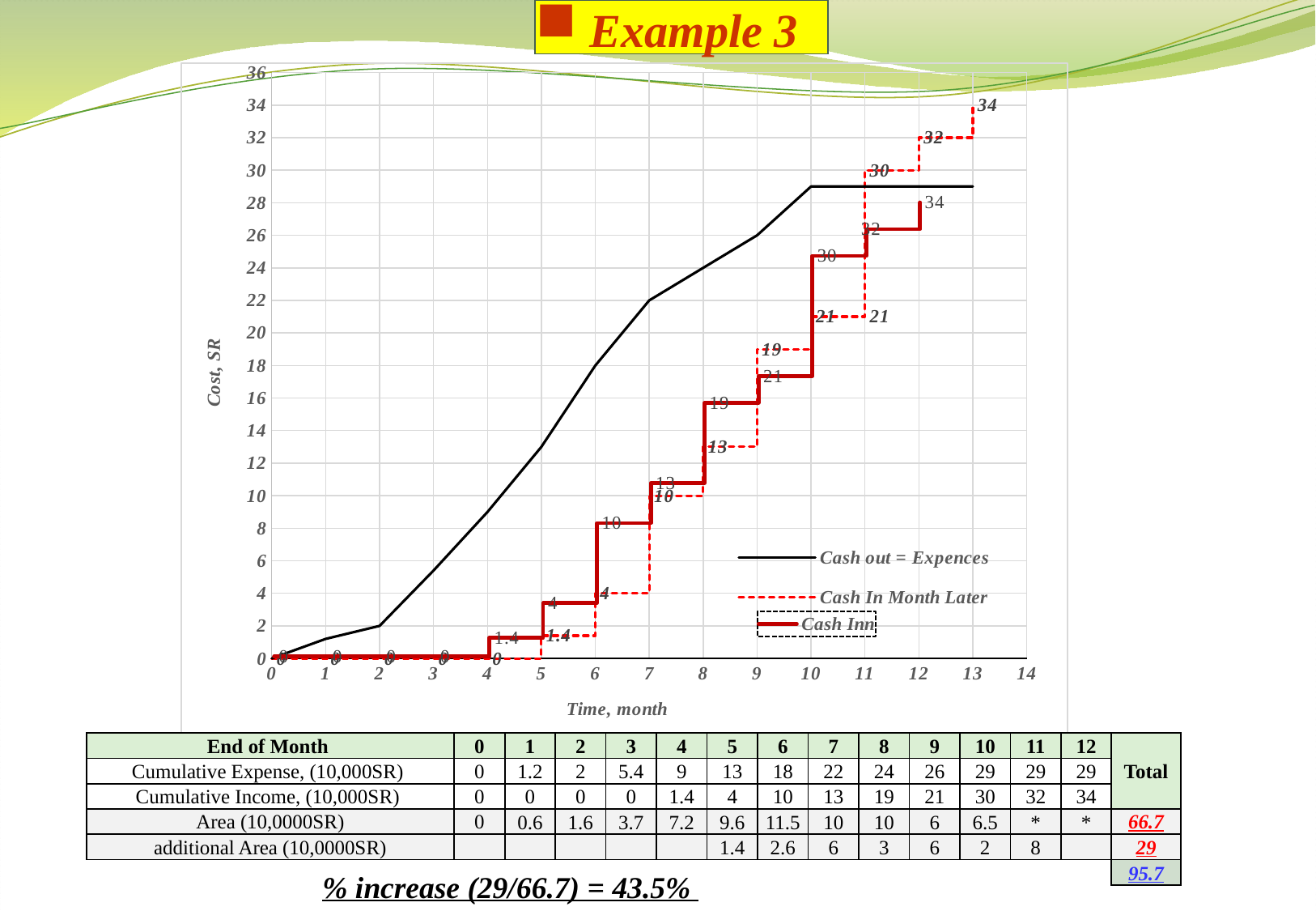
What is the difference between the Cash Inn values at month 12 and month 11? 2 What kind of chart is shown on the slide? line chart What is the value of the Cash In Month Later series at month 13? 34 Is the value of the Cash out = Expences series at month 5 greater or less than 12? greater Does the Cash Inn series rise or fall as time increases along the x axis? rise What is the title of the x axis of the chart? Time, month What is the value of the Cash Inn series at month 8? 19 What is the value of the Cash Inn series at month 12? 34 At month 8, which is larger: Cash out = Expences or Cash Inn? Cash out = Expences What is the value of the Cash In Month Later series at month 11? 30 How many series does the chart legend list? 3 Which series has the highest value at month 12? Cash Inn